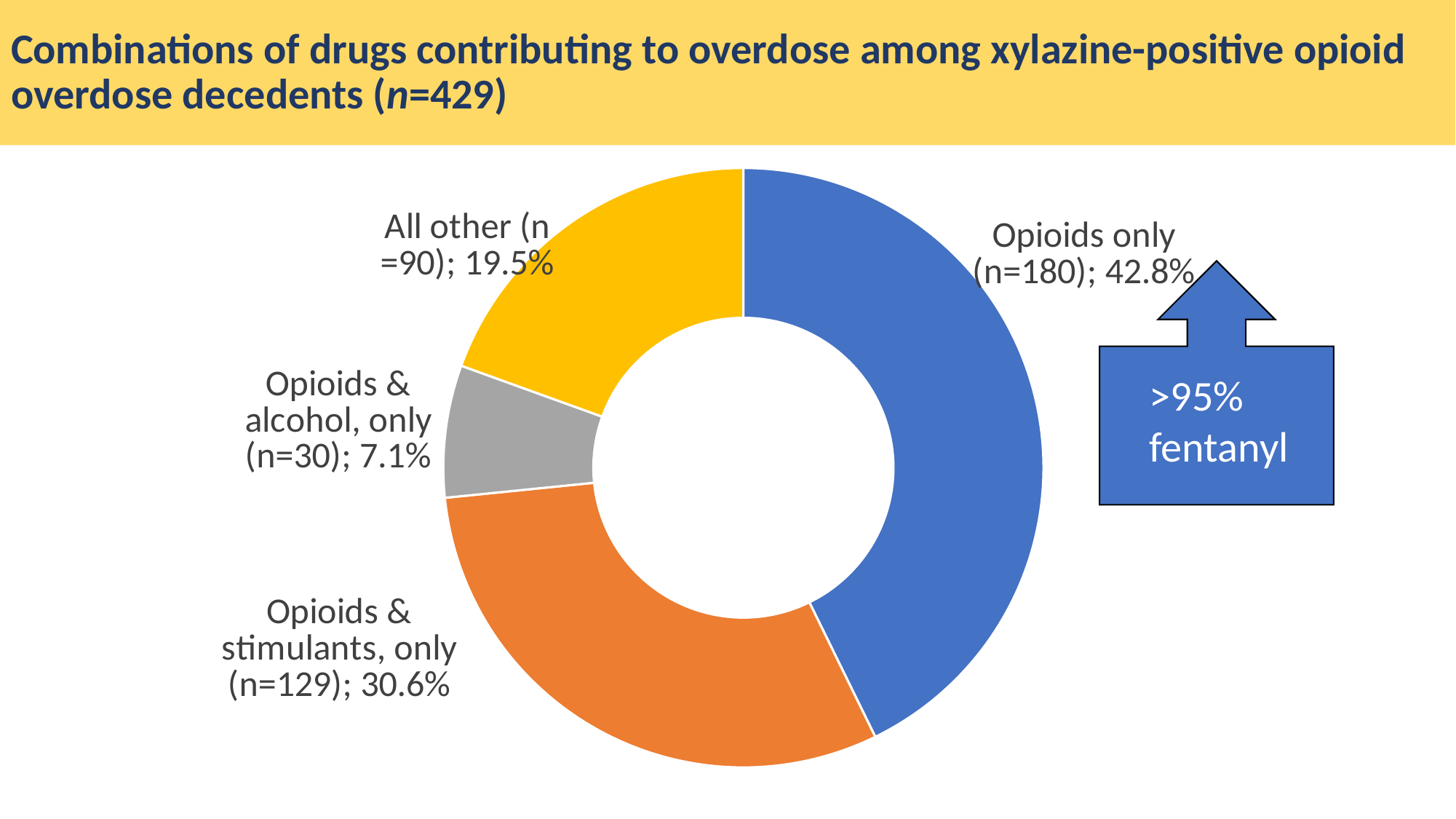
Which is larger: the share for 'All other' or the share for 'Opioids & alcohol, only'? All other What percentage share does the 'Opioids & alcohol, only' slice represent? 7.1% How many decedents fall into the 'All other' category? 90 Which category has the largest share of the pie? Opioids only What is the total number of decedents (n) stated in the chart title? 429 How many decedents are in the 'Opioids & stimulants, only' category? 129 What is the difference in count between 'Opioids only' and 'Opioids & stimulants, only'? 51 Which category has the smallest share of the pie? Opioids & alcohol, only What percentage of decedents had opioids only contributing to overdose? 42.8% What kind of chart is shown on the slide? Pie chart (doughnut) What does the callout box next to the 'Opioids only' slice say? >95% fentanyl How many slices does the pie chart have? 4